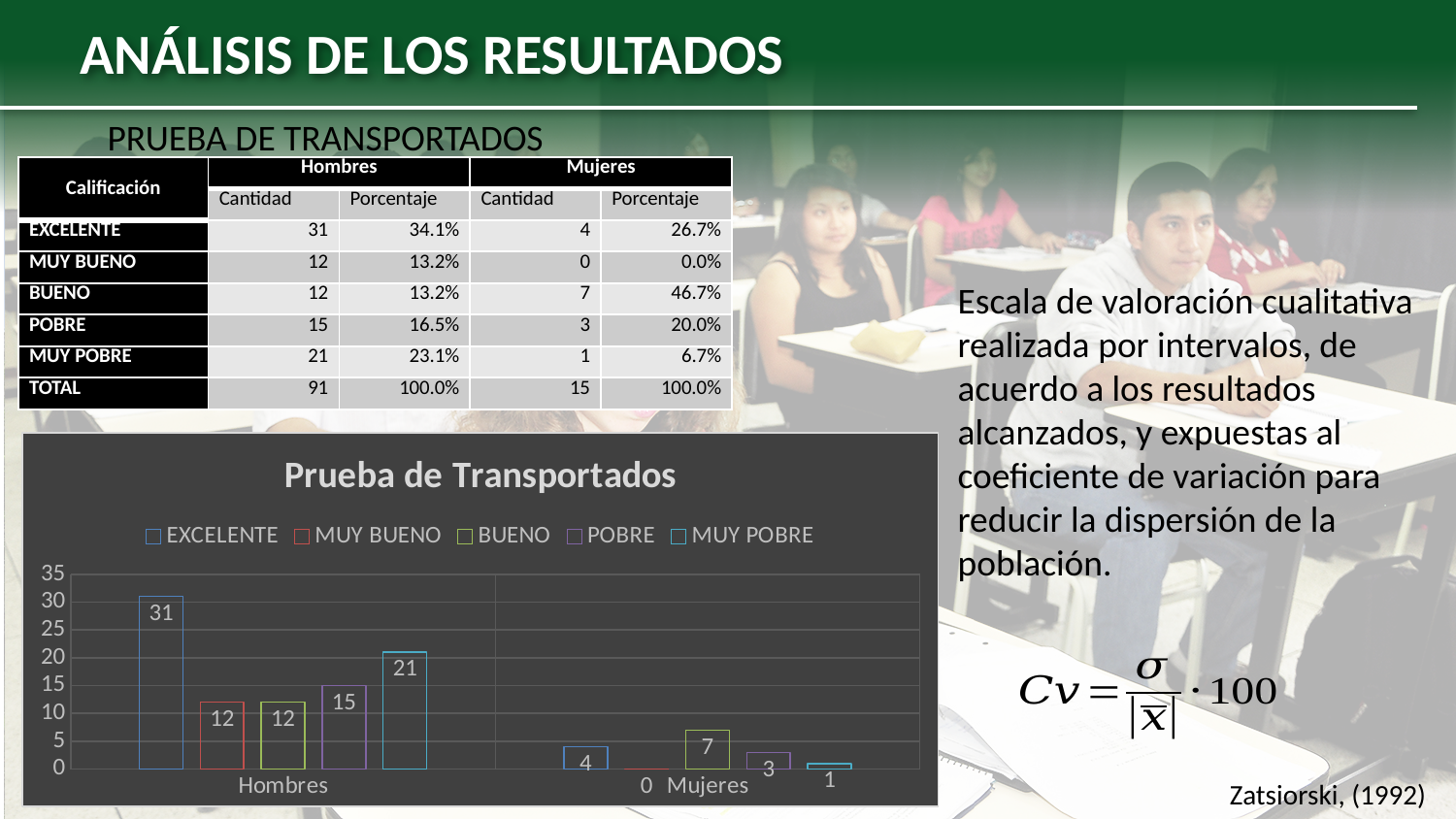
Which series has the highest value in the Hombres category? EXCELENTE What type of chart is shown on the slide? bar chart How many series does the chart legend list? 5 What is the value for BUENO in the Mujeres category? 7 Which is larger: the POBRE value for Hombres or the MUY POBRE value for Hombres? MUY POBRE How many categories are shown on the x axis of the chart? 2 What is the value for EXCELENTE in the Hombres category? 31 Which series has the lowest value in the Mujeres category? MUY BUENO What is the title of the chart? Prueba de Transportados What is the value for MUY BUENO in the Mujeres category? 0 What is the value for MUY POBRE in the Hombres category? 21 What is the difference between the EXCELENTE value for Hombres and the EXCELENTE value for Mujeres? 27